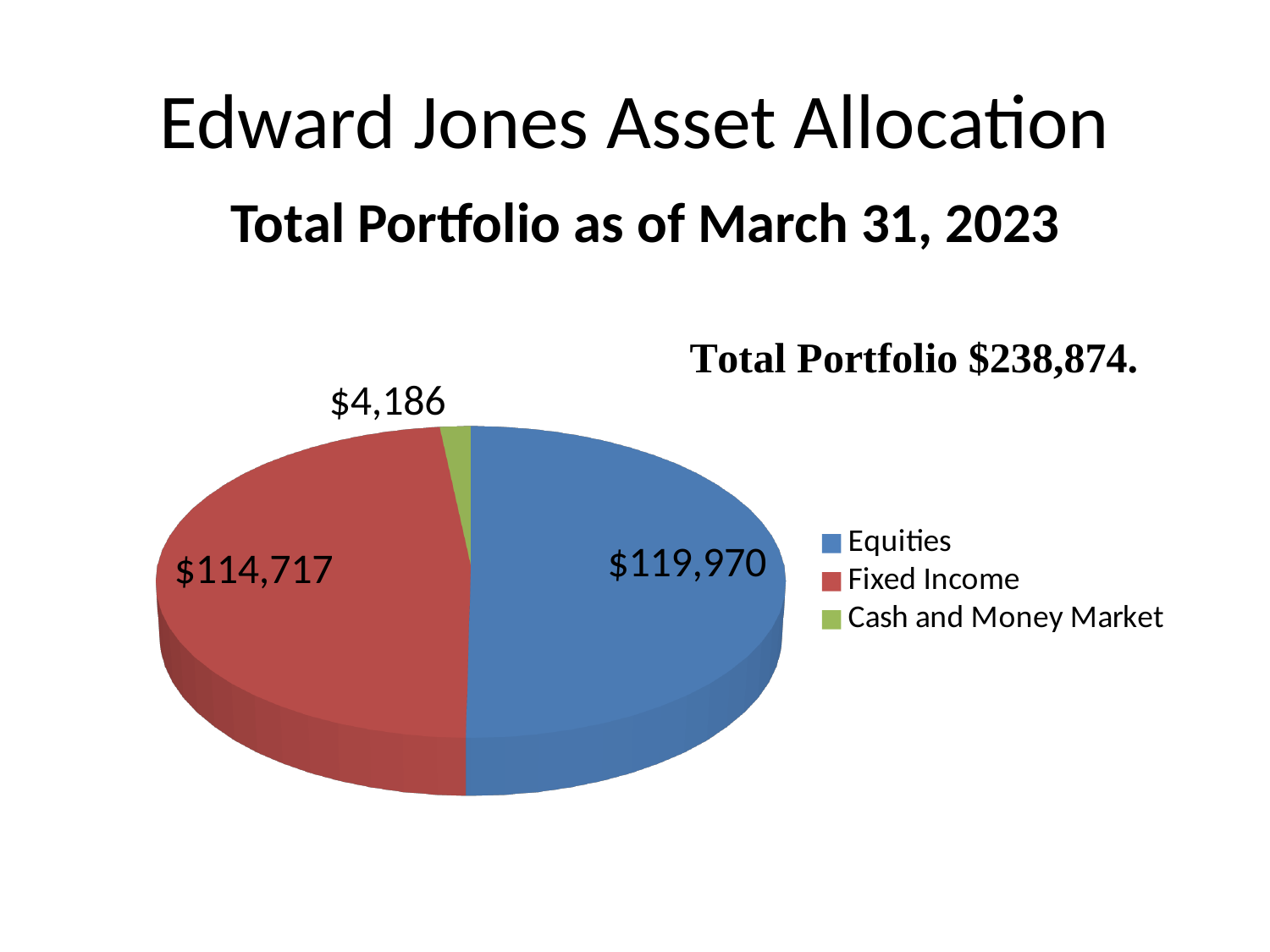
What total portfolio value is stated on the slide? $238,874 Which category has the largest value according to the data labels? Equities What is the value for Equities? $119,970 What is the value for Cash and Money Market? $4,186 What is the difference between the Equities value and the Fixed Income value? $5,253 Which colour represents Fixed Income in the legend? Red What kind of chart is shown on the slide? Pie chart What is the value for Fixed Income? $114,717 How many categories does the pie chart show? 3 What is the difference between the Fixed Income value and the Cash and Money Market value? $110,531 Which is larger, the value for Fixed Income or the value for Cash and Money Market? Fixed Income Which category has the smallest slice of the pie? Cash and Money Market